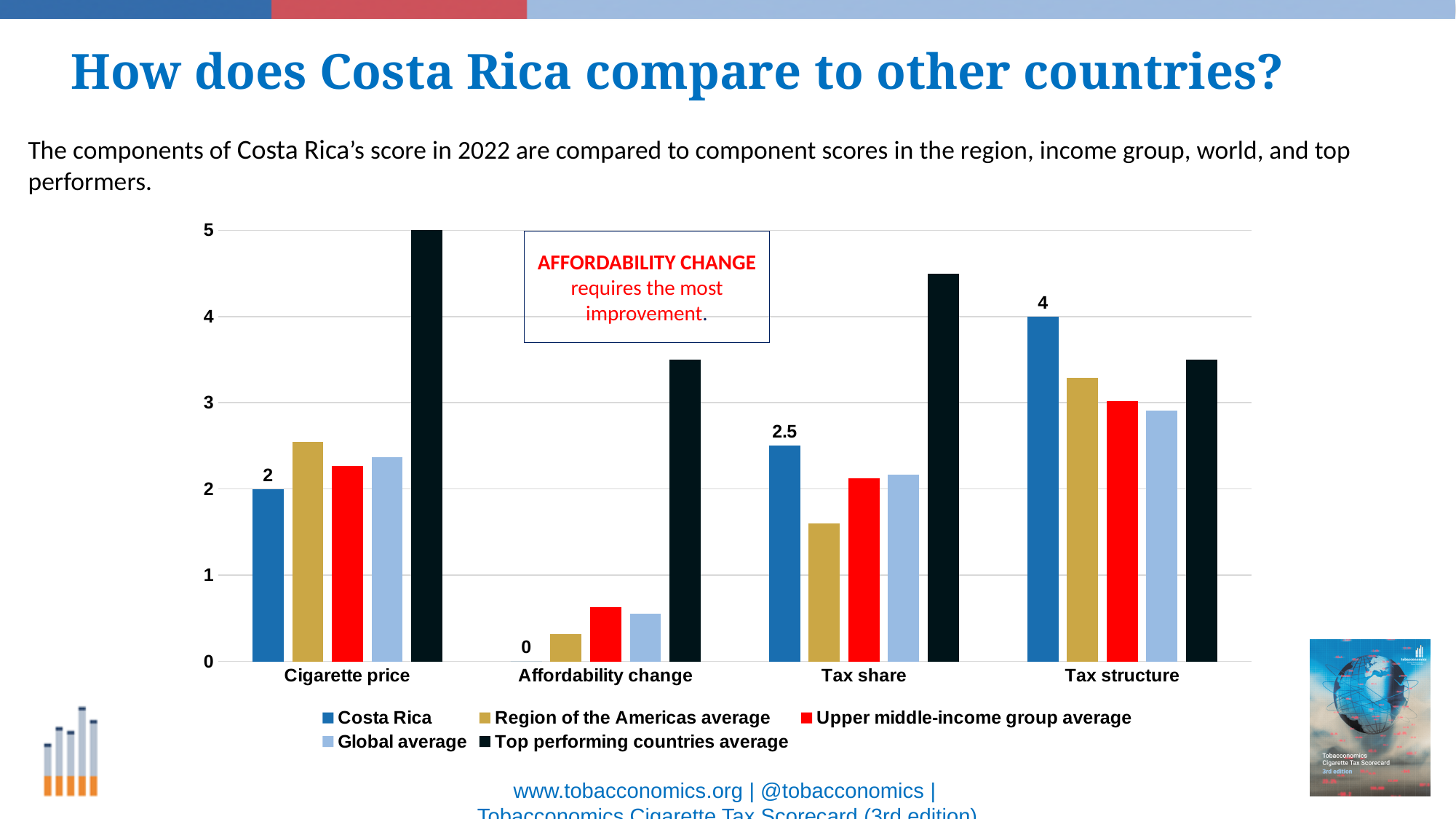
What kind of chart is shown on the slide? bar chart What is Costa Rica's score for Tax structure? 4 How many series does the legend list? 5 Is the Top performing countries average for Affordability change greater or less than 3? greater Which component has the highest Costa Rica score? Tax structure What is the difference between Costa Rica's Tax structure score and its Cigarette price score? 2 What is Costa Rica's score for Affordability change? 0 What is Costa Rica's score for Tax share? 2.5 For Costa Rica, which is larger: the Tax share score or the Cigarette price score? Tax share Which component has the lowest Costa Rica score? Affordability change What is Costa Rica's score for Cigarette price? 2 How many components (categories) are shown on the x axis? 4